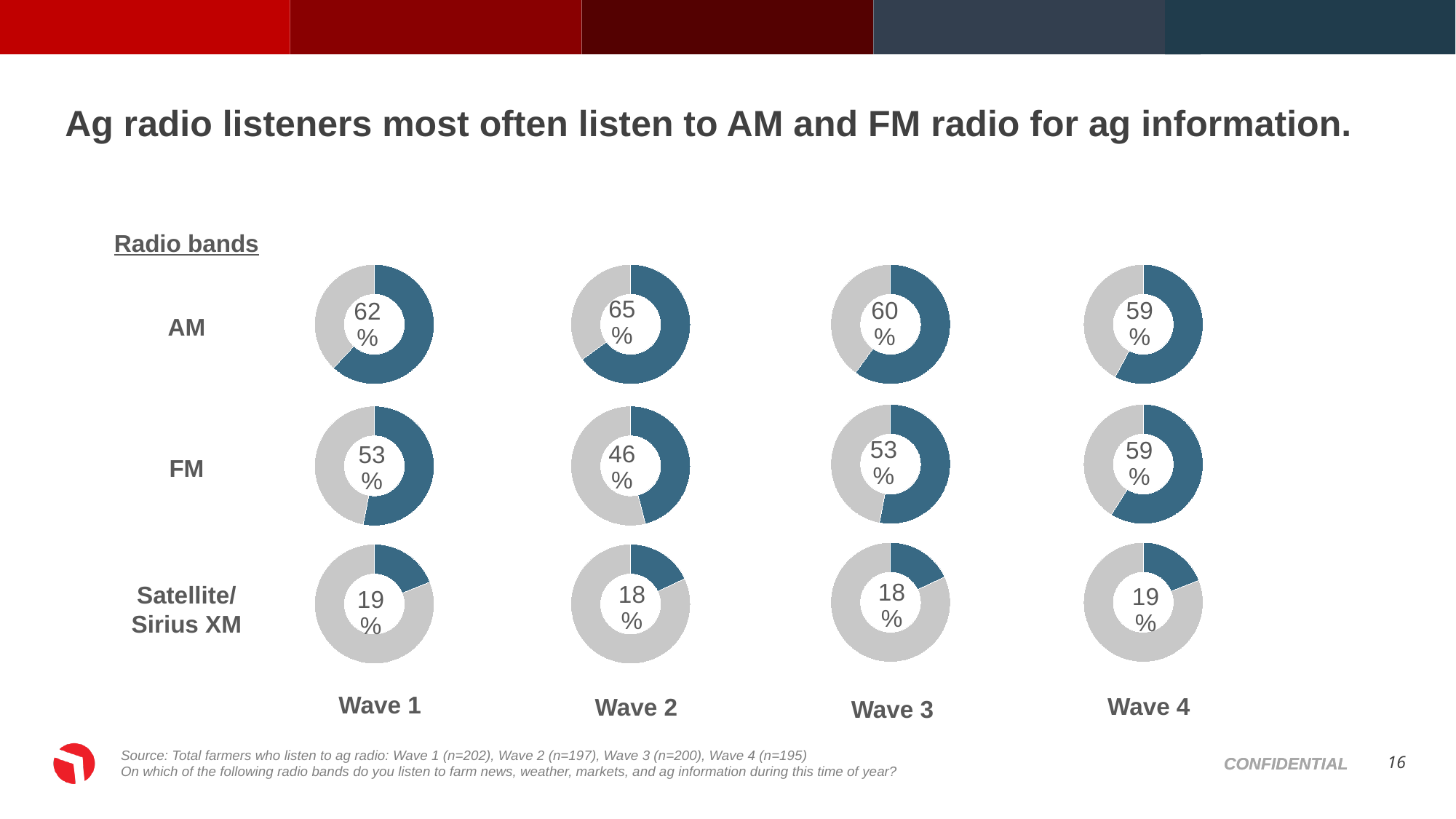
How many waves are shown for each radio band? 4 In which wave was the AM radio percentage highest? Wave 2 What percentage of ag radio listeners listened to FM radio in Wave 4? 59% In which wave was the FM radio percentage lowest? Wave 2 How many radio bands are shown on the slide? 3 What percentage of ag radio listeners listened to AM radio in Wave 2? 65% Which is larger in Wave 3: the AM percentage or the FM percentage? AM What is the difference between the FM percentages in Wave 1 and Wave 2? 7 percentage points Did the FM radio percentage rise or fall from Wave 3 to Wave 4? Rise What is the difference between the AM and FM percentages in Wave 2? 19 percentage points What percentage of ag radio listeners listened to Satellite/Sirius XM in Wave 1? 19% What kind of chart is used to show each percentage on the slide? Donut (pie) chart